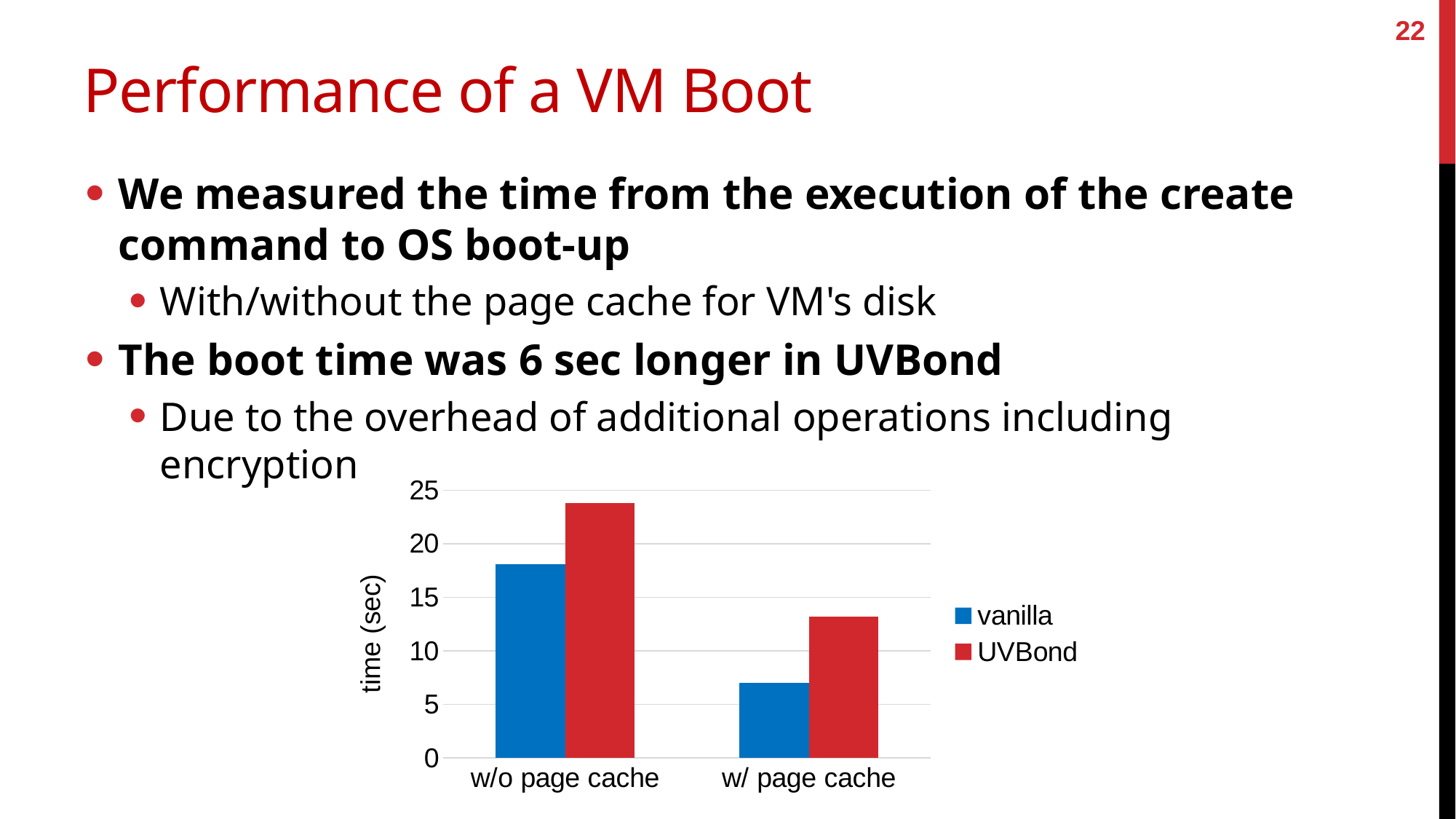
For w/ page cache, which series has the larger value, vanilla or UVBond? UVBond Which bar is the shortest in the chart? vanilla w/ page cache What is the label of the y axis of the chart? time (sec) How many series does the chart legend list? 2 What kind of chart is shown on the slide? bar chart Is the value for vanilla w/ page cache greater or less than 10? less Is the value for UVBond w/o page cache greater or less than 20? greater Which series is drawn in red in the chart? UVBond Is the value for vanilla w/o page cache greater or less than 20? less How many categories are shown on the x axis of the chart? 2 Which bar is the tallest in the chart? UVBond w/o page cache